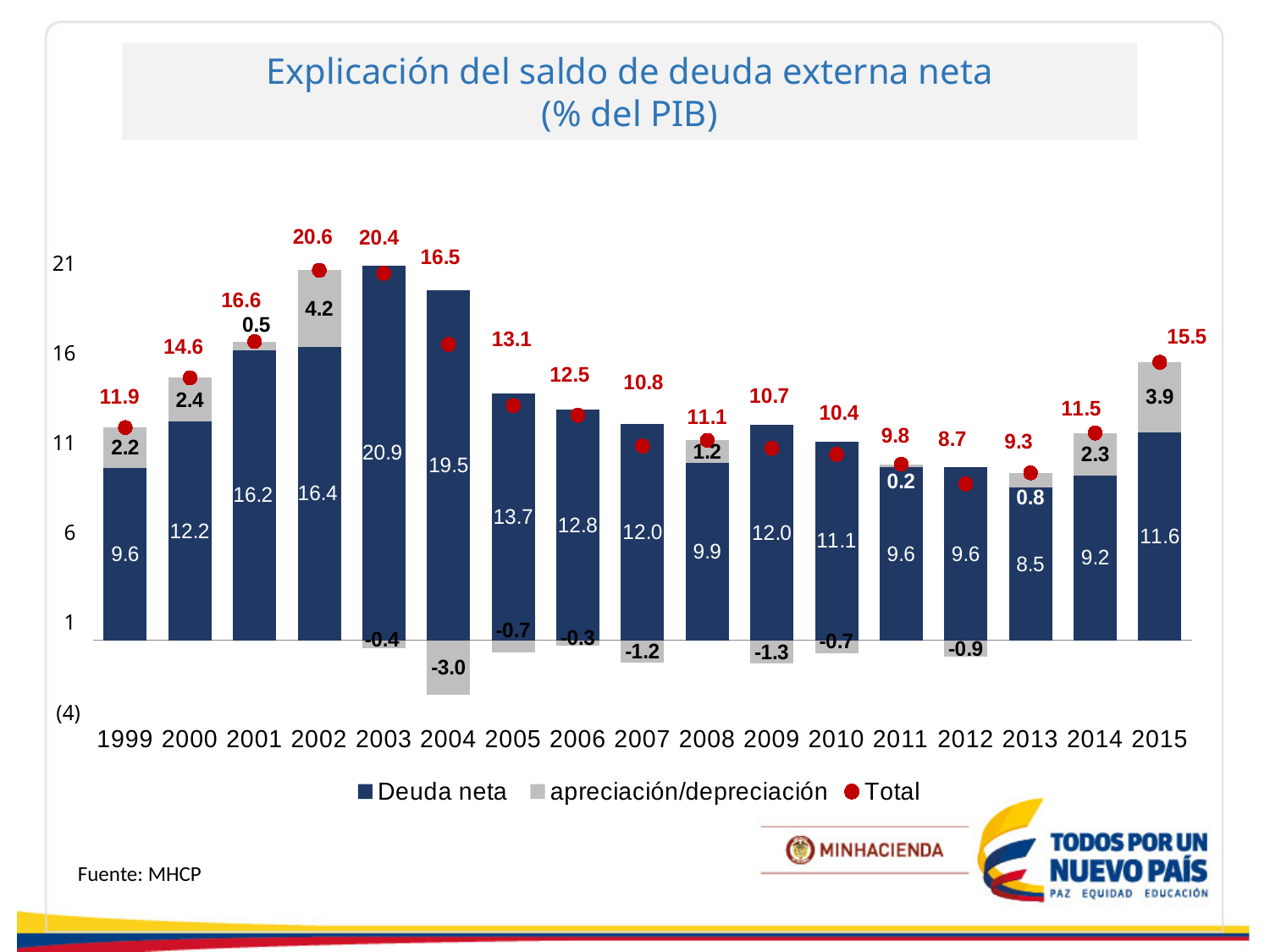
Does the Total value rise or fall from 2002 to 2012? Fall How many years are shown on the x axis? 17 What is the Deuda neta value for 2003? 20.9 Which year has the lowest Total value? 2012 How many series does the legend list? 3 What is the Total value for 2015? 15.5 What is the apreciación/depreciación value for 2004? -3.0 Which year has the lowest Deuda neta value? 2013 What is the difference between the Deuda neta values for 2003 and 2013? 12.4 What kind of chart is shown on the slide? Bar chart Which year has the larger Deuda neta value, 2004 or 2005? 2004 Which year has the highest Total value? 2002